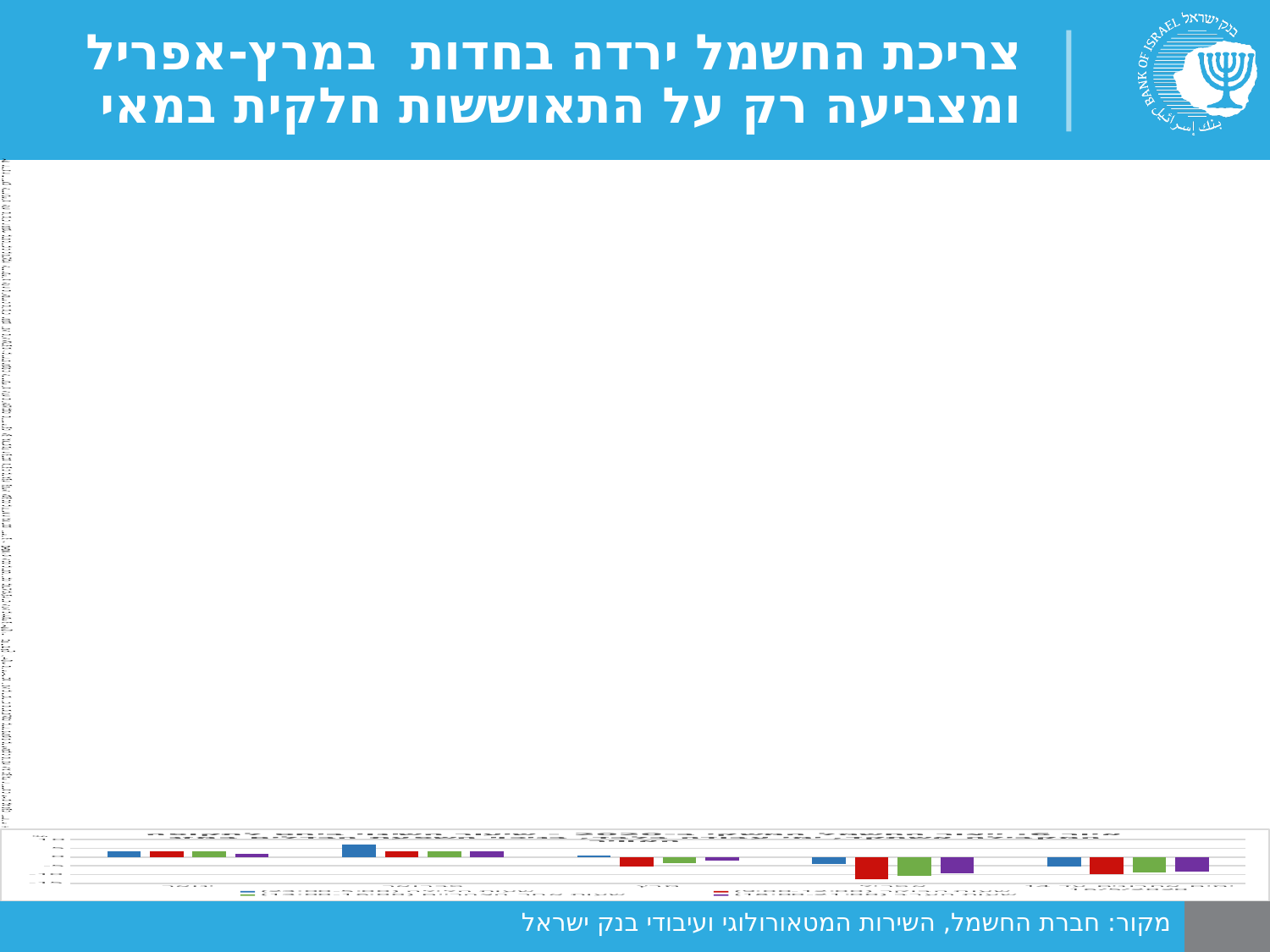
What kind of chart is shown at the bottom of the slide? bar chart How many differently coloured series are plotted in the bar chart? 4 Moving from left to right along the x axis, do the bar values generally rise or fall? fall How many groups of bars are shown along the x axis of the chart? 5